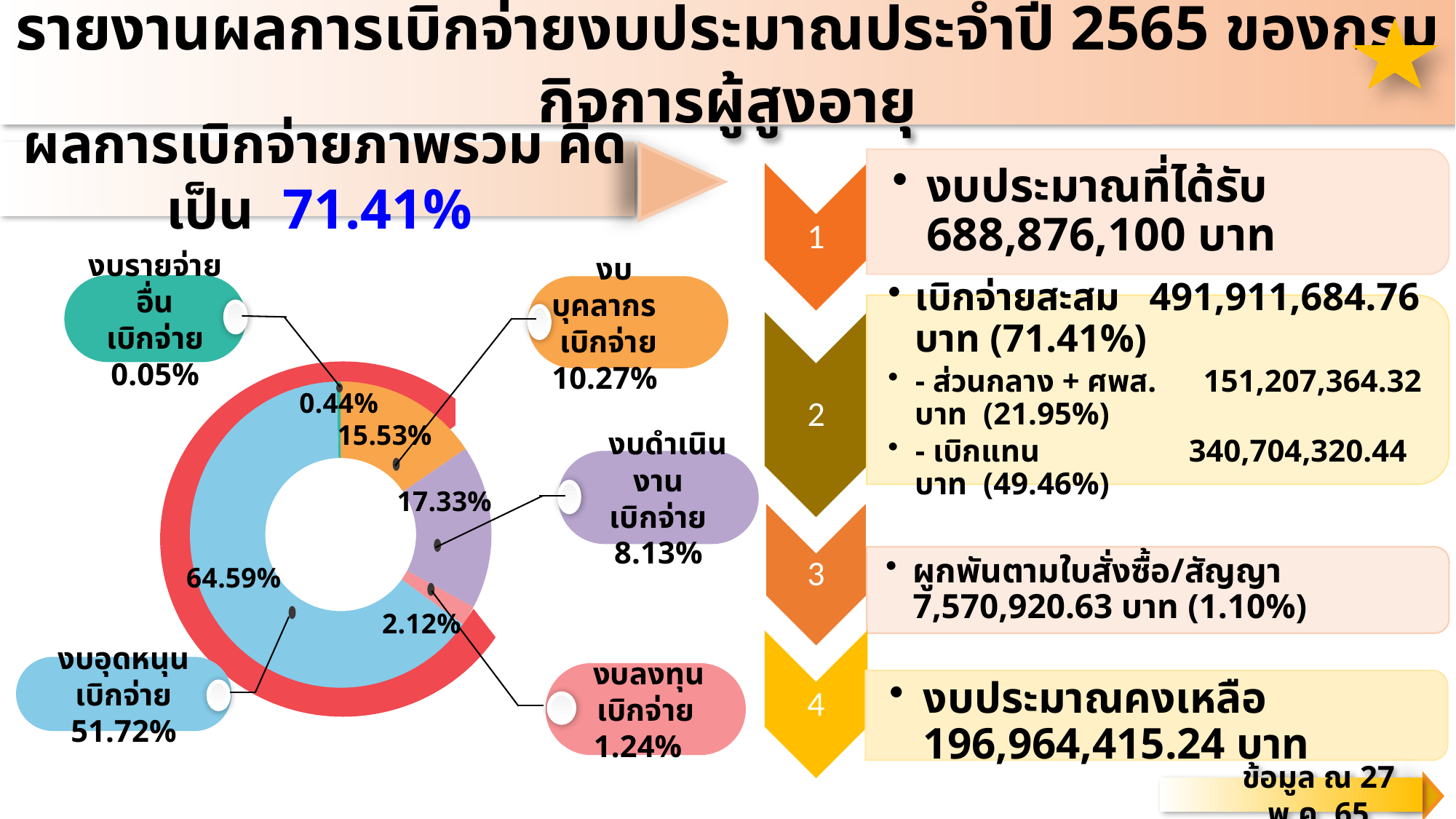
Which slice of the doughnut chart is the largest? 64.59% (งบอุดหนุน) How many slices with data labels does the doughnut chart have? 5 According to the callout, what is the disbursement percentage for งบบุคลากร เบิกจ่าย? 10.27% What percentage is shown on the orange slice of the doughnut chart (งบบุคลากร)? 15.53% Which is larger in the doughnut chart: the purple slice (งบดำเนินงาน) or the orange slice (งบบุคลากร)? Purple slice (งบดำเนินงาน), 17.33% What colour is the largest slice (64.59%) of the doughnut chart? Light blue What percentage is shown on the purple slice of the doughnut chart (งบดำเนินงาน)? 17.33% What kind of chart is shown on the left of the slide? Doughnut (pie) chart According to the callout, what is the disbursement percentage for งบอุดหนุน เบิกจ่าย? 51.72% What is the difference between the purple slice (17.33%) and the orange slice (15.53%) in the doughnut chart? 1.80% What percentage is shown on the pink slice of the doughnut chart (งบลงทุน)? 2.12% Which slice of the doughnut chart is the smallest? 0.44% (งบรายจ่ายอื่น)